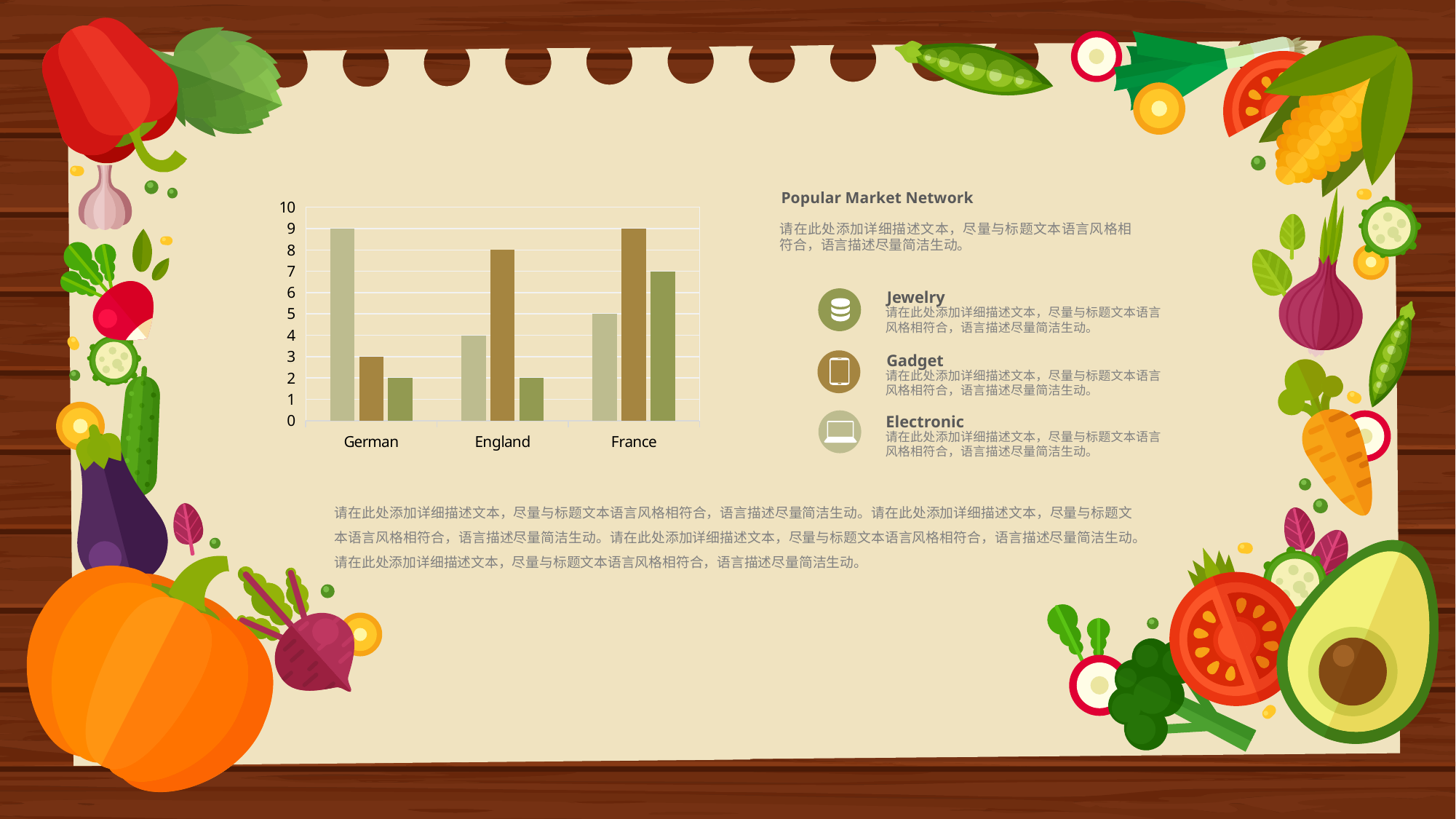
What is the value of the middle (brown) bar for England? 8 What kind of chart is shown on the slide? bar chart Which is larger: the first (lightest) bar for England or the first (lightest) bar for France? France Which category has the highest first (lightest) bar? German What is the value of the first (lightest) bar for German? 9 Do the values of the third (olive green) bars rise or fall from England to France? rise What is the maximum value shown on the chart's vertical axis? 10 What is the difference between the middle (brown) bar for France and the middle (brown) bar for German? 6 How many categories are shown on the x axis of the chart? 3 What is the value of the middle (brown) bar for German? 3 Which category has the lowest middle (brown) bar? German What is the value of the third (olive green) bar for France? 7